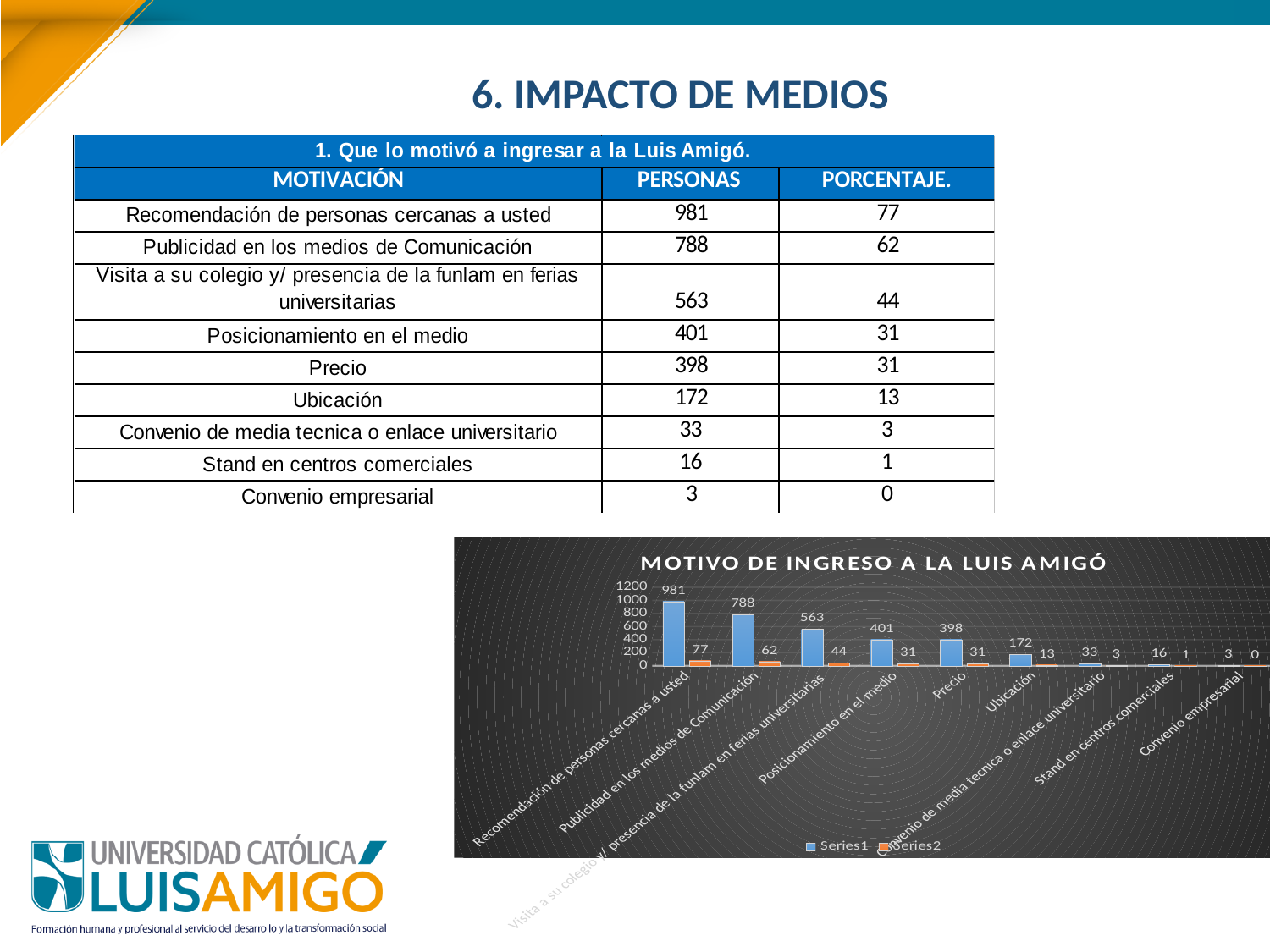
What is the Series2 value for Ubicación in the chart? 13 How many categories are plotted on the x axis of the chart? 9 What is the difference between the Series1 values for Recomendación de personas cercanas a usted and Publicidad en los medios de Comunicación? 193 What is the Series1 value for Stand en centros comerciales in the chart? 16 Do the Series1 values rise or fall from left to right along the x axis? fall What is the title of the chart? MOTIVO DE INGRESO A LA LUIS AMIGÓ How many series does the chart legend list? 2 Which has a larger Series1 value: Posicionamiento en el medio or Ubicación? Posicionamiento en el medio Which category has the lowest Series1 value in the chart? Convenio empresarial What is the Series1 value for Precio in the chart? 398 What type of chart is shown on the slide? bar chart Which category has the highest Series1 value in the chart? Recomendación de personas cercanas a usted